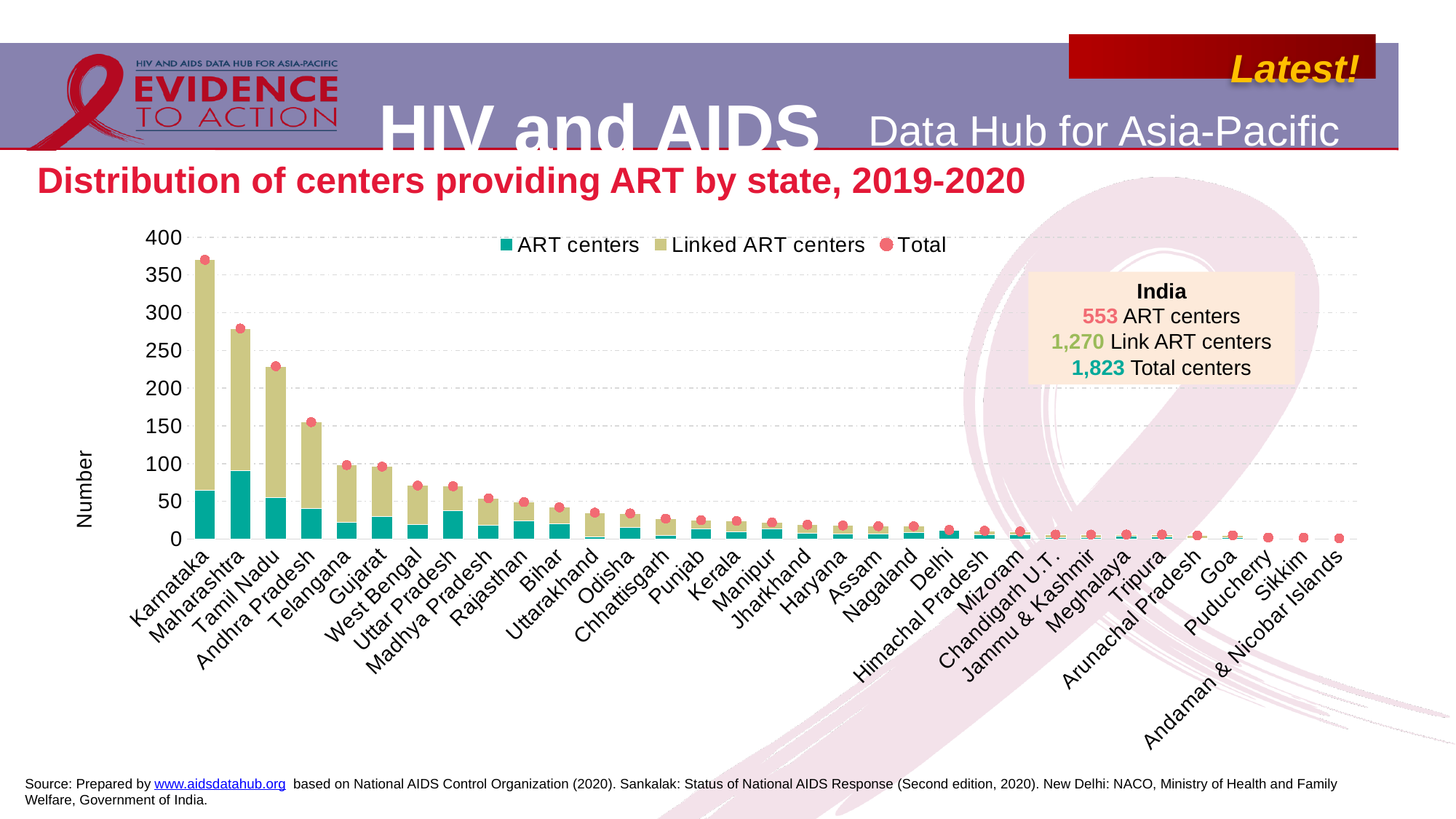
Which state has the highest total number of centers providing ART? Karnataka Do the total values rise or fall moving from left to right along the x axis? Fall Is the total number of centers for Maharashtra greater or less than 250? greater Is the total number of centers for Karnataka greater or less than 350? greater Is the total number of centers for Tamil Nadu greater or less than 200? greater Which state has more total centers, Karnataka or Maharashtra? Karnataka Which state has more ART centers (teal segment), Maharashtra or Karnataka? Maharashtra What kind of chart is shown on the slide? Bar chart (stacked, with total markers) How many states or territories are shown on the x axis? 33 How many series does the chart legend list? 3 According to the text box, how many total centers does India have? 1,823